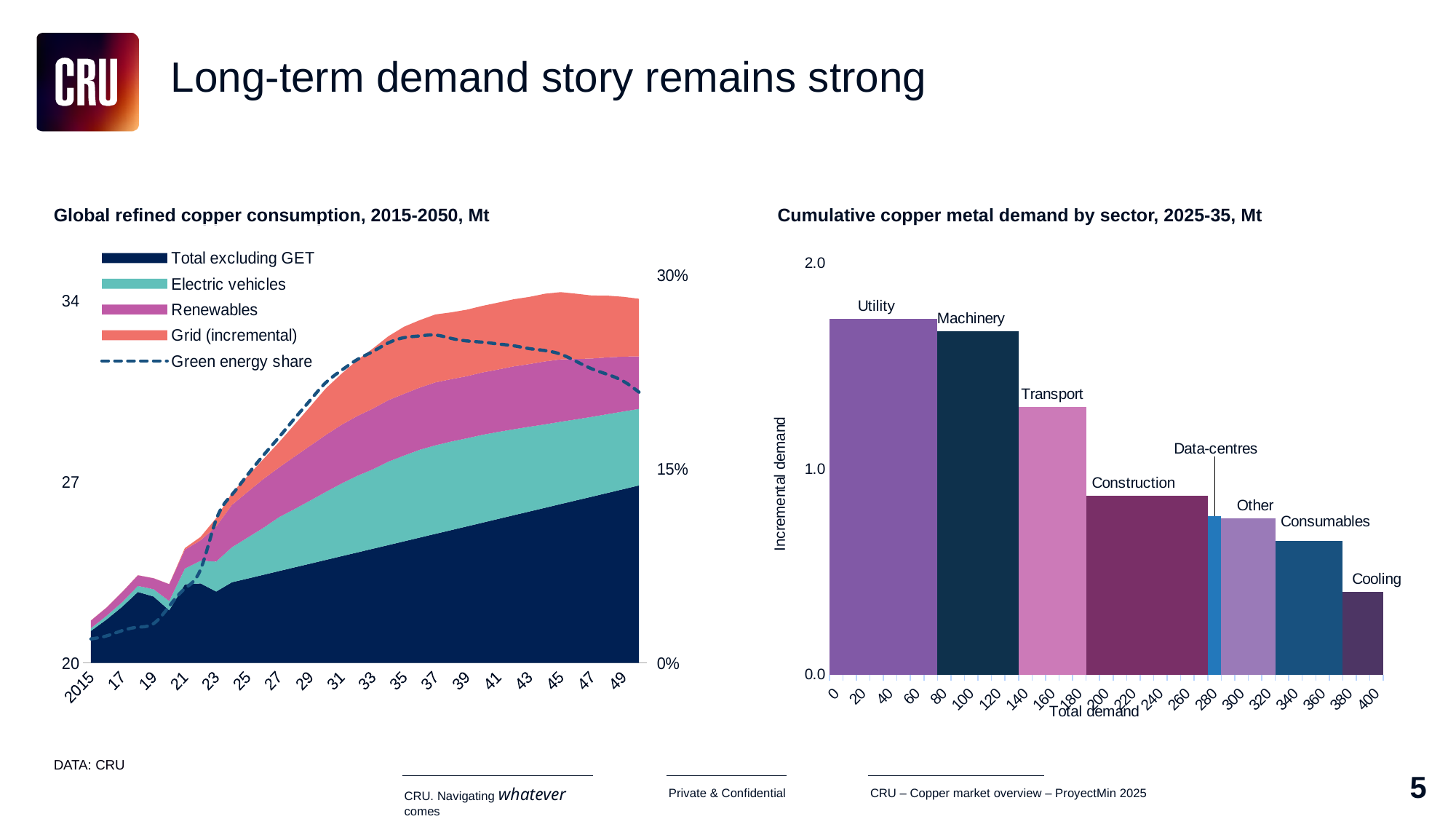
In the chart titled 'Global refined copper consumption, 2015-2050, Mt', is the Green energy share in 2015 greater or less than 15%? less In the chart titled 'Cumulative copper metal demand by sector, 2025-35, Mt', is the incremental demand for Cooling greater or less than 1.0? less In the chart titled 'Cumulative copper metal demand by sector, 2025-35, Mt', which sector has the lowest incremental demand? Cooling In the chart titled 'Global refined copper consumption, 2015-2050, Mt', does the 'Total excluding GET' series generally rise or fall from 2015 to 2049? Rise In the chart titled 'Cumulative copper metal demand by sector, 2025-35, Mt', is the incremental demand for Transport greater or less than 1.0? greater In the chart titled 'Global refined copper consumption, 2015-2050, Mt', which legend entry is drawn as a dashed line? Green energy share In the chart titled 'Cumulative copper metal demand by sector, 2025-35, Mt', which sector has the highest incremental demand? Utility In the chart titled 'Cumulative copper metal demand by sector, 2025-35, Mt', which has the larger incremental demand, Machinery or Construction? Machinery In the chart titled 'Cumulative copper metal demand by sector, 2025-35, Mt', how many sectors are shown? 8 In the chart titled 'Global refined copper consumption, 2015-2050, Mt', how many entries does the legend list? 5 What kind of chart is the one titled 'Cumulative copper metal demand by sector, 2025-35, Mt'? Bar chart